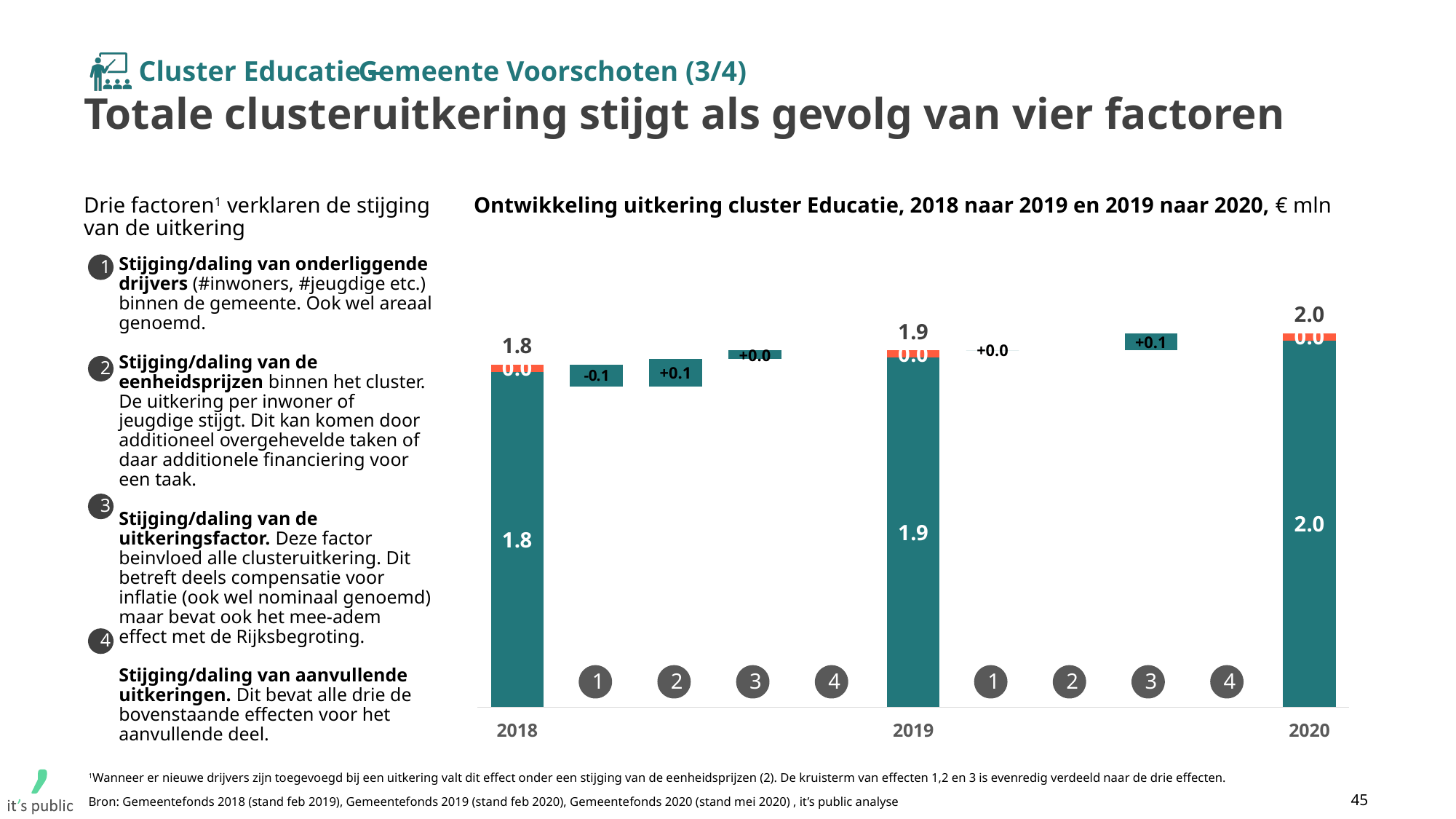
In what unit are the values in the chart expressed? € mln What is the effect of factor 2 on the uitkering from 2018 to 2019? +0.1 Which year has the lowest total uitkering in the chart? 2018 What is the total uitkering for cluster Educatie in 2020 according to the chart? 2.0 What is the effect of factor 1 on the uitkering from 2019 to 2020? +0.0 What is the total uitkering for cluster Educatie in 2018 according to the chart? 1.8 Which year has the highest total uitkering in the chart? 2020 Do the total uitkering values rise or fall from 2018 to 2020? rise What is the difference between the total uitkering in 2020 and in 2018? 0.2 What is the total uitkering for cluster Educatie in 2019 according to the chart? 1.9 What is the effect of factor 3 on the uitkering from 2019 to 2020? +0.1 What is the effect of factor 1 on the uitkering from 2018 to 2019? -0.1